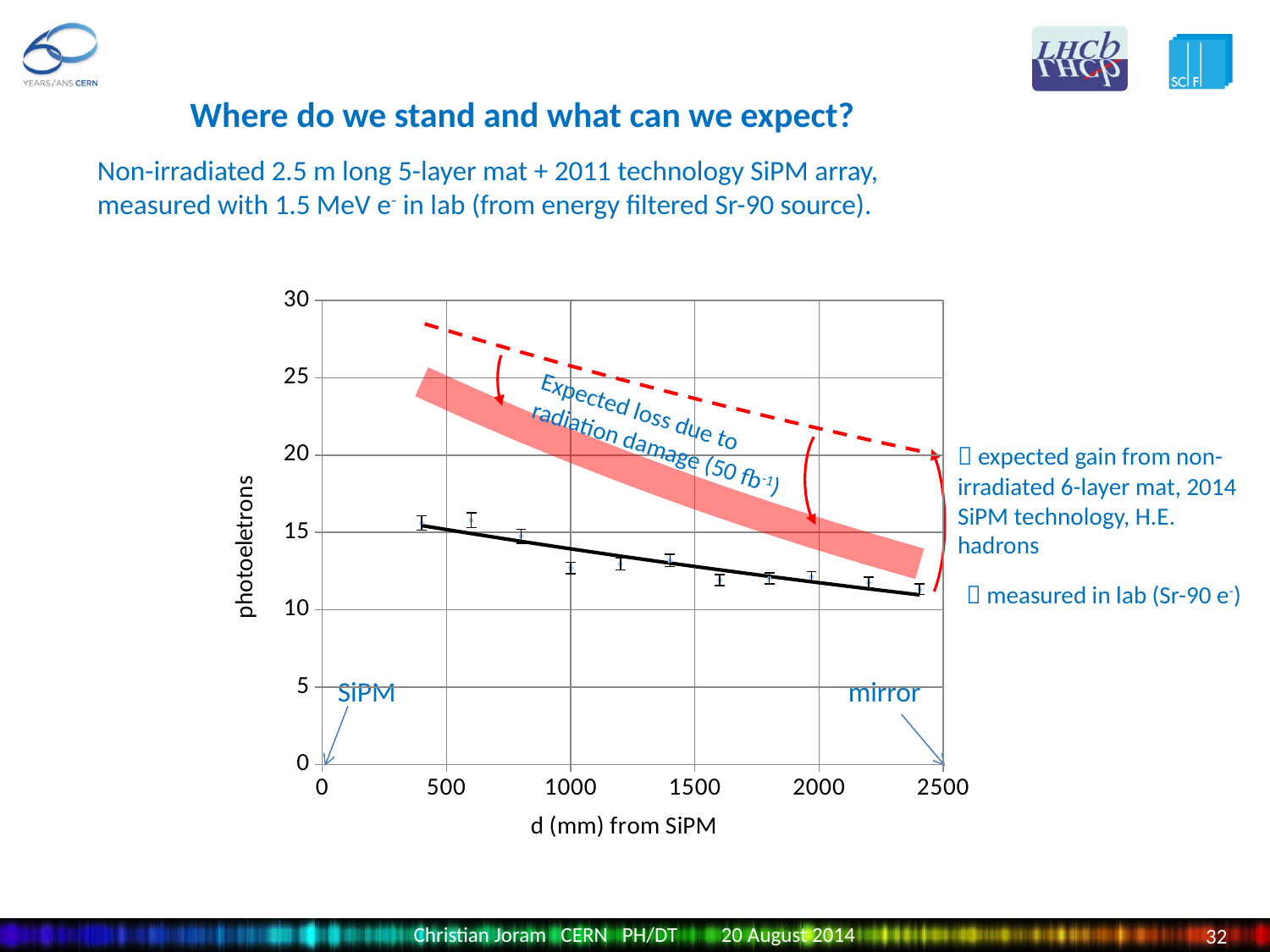
Is the dashed expected-gain line at d = 500 mm greater or less than 25 photoelectrons? greater How many measured data points (with error bars) are plotted on the chart? 11 Do the measured photoelectron values rise or fall as d (mm) from SiPM increases? fall Is the measured photoelectron value at d = 1000 mm greater or less than 15? less What is the label of the y axis of the chart? photoeletrons Which measured point has more photoelectrons, the one at d = 400 mm or the one at d = 2400 mm? d = 400 mm Is the measured photoelectron value at d = 2400 mm greater or less than 10? greater What is the label of the x axis of the chart? d (mm) from SiPM What kind of chart is shown on the slide? line chart